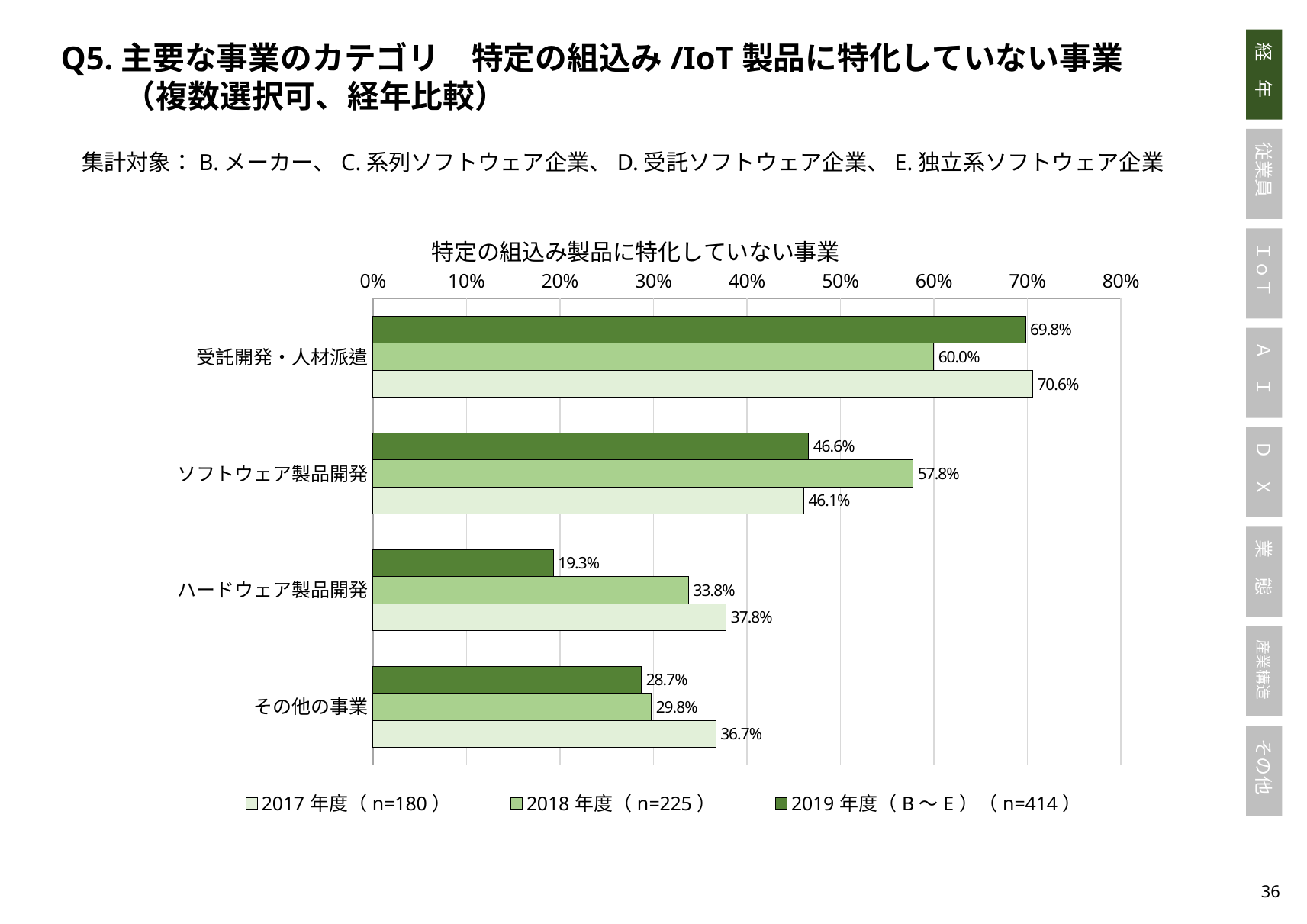
Which category has the lowest value in the 2019年度 series? ハードウェア製品開発 What is the value for 受託開発・人材派遣 in the 2019年度 series? 69.8% How many series does the legend list? 3 Which category has the highest value in the 2019年度 series? 受託開発・人材派遣 What is the value for ソフトウェア製品開発 in the 2018年度 series? 57.8% What is the difference between the 2017年度 and 2019年度 values for ハードウェア製品開発? 18.5% How many categories are shown on the chart? 4 What is the value for その他の事業 in the 2019年度 series? 28.7% Which is larger for ソフトウェア製品開発: the 2018年度 value or the 2019年度 value? 2018年度 What is the value for ハードウェア製品開発 in the 2017年度 series? 37.8% What kind of chart is shown on the slide? Bar chart What is the title of the chart? 特定の組込み製品に特化していない事業